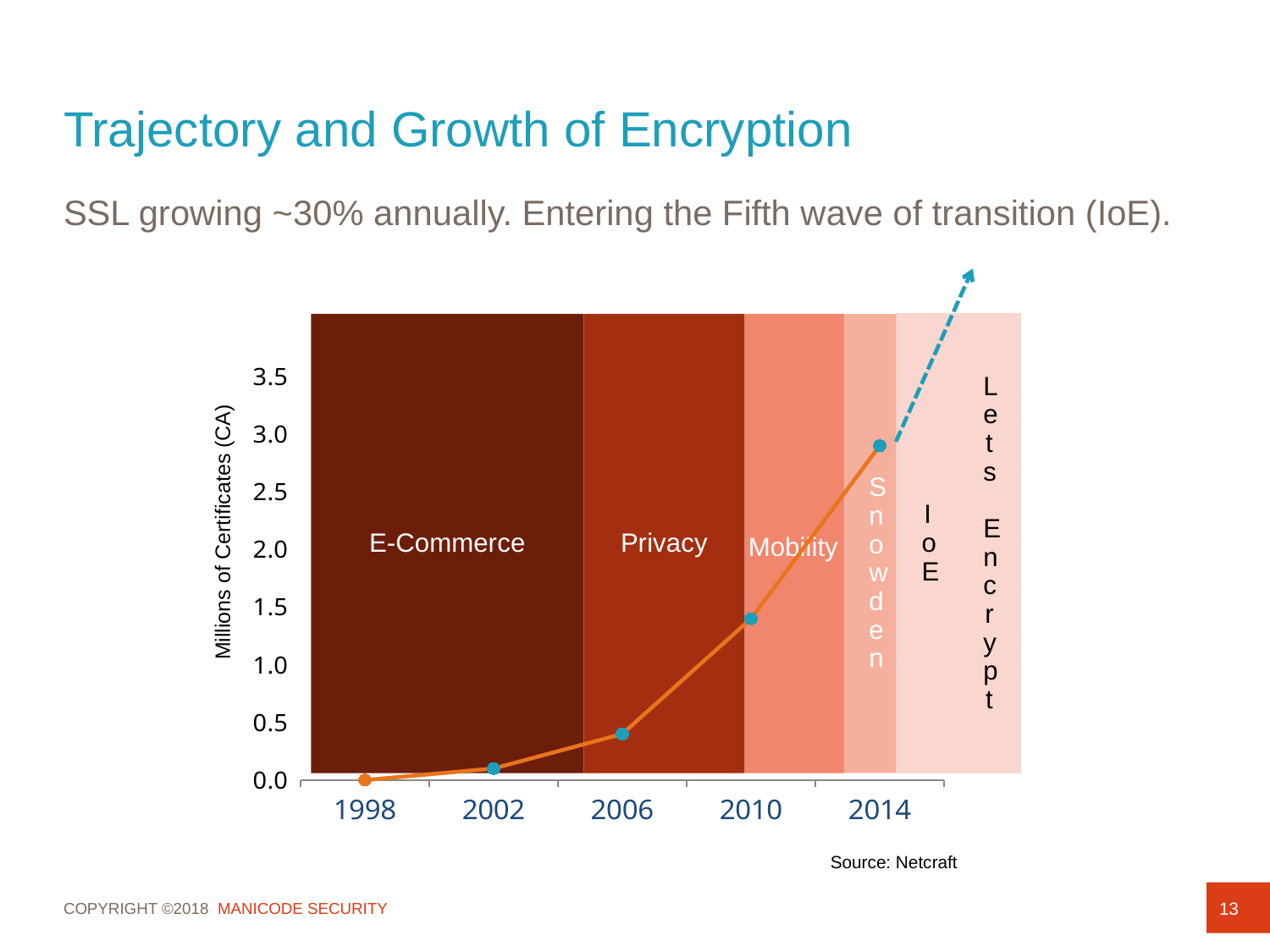
Which year has the larger value, 2006 or 2010? 2010 Which year has the lowest number of certificates? 1998 Do the values rise or fall from 1998 to 2014? rise How many data points are plotted on the line? 5 What is the label on the vertical axis? Millions of Certificates (CA) Is the value for 2014 greater or less than 2.5? greater What source is cited below the chart? Netcraft Which year has the highest number of certificates? 2014 Is the value for 2010 greater or less than 1.0? greater Is the value for 2006 greater or less than 1.0? less What kind of chart is shown on the slide? line chart